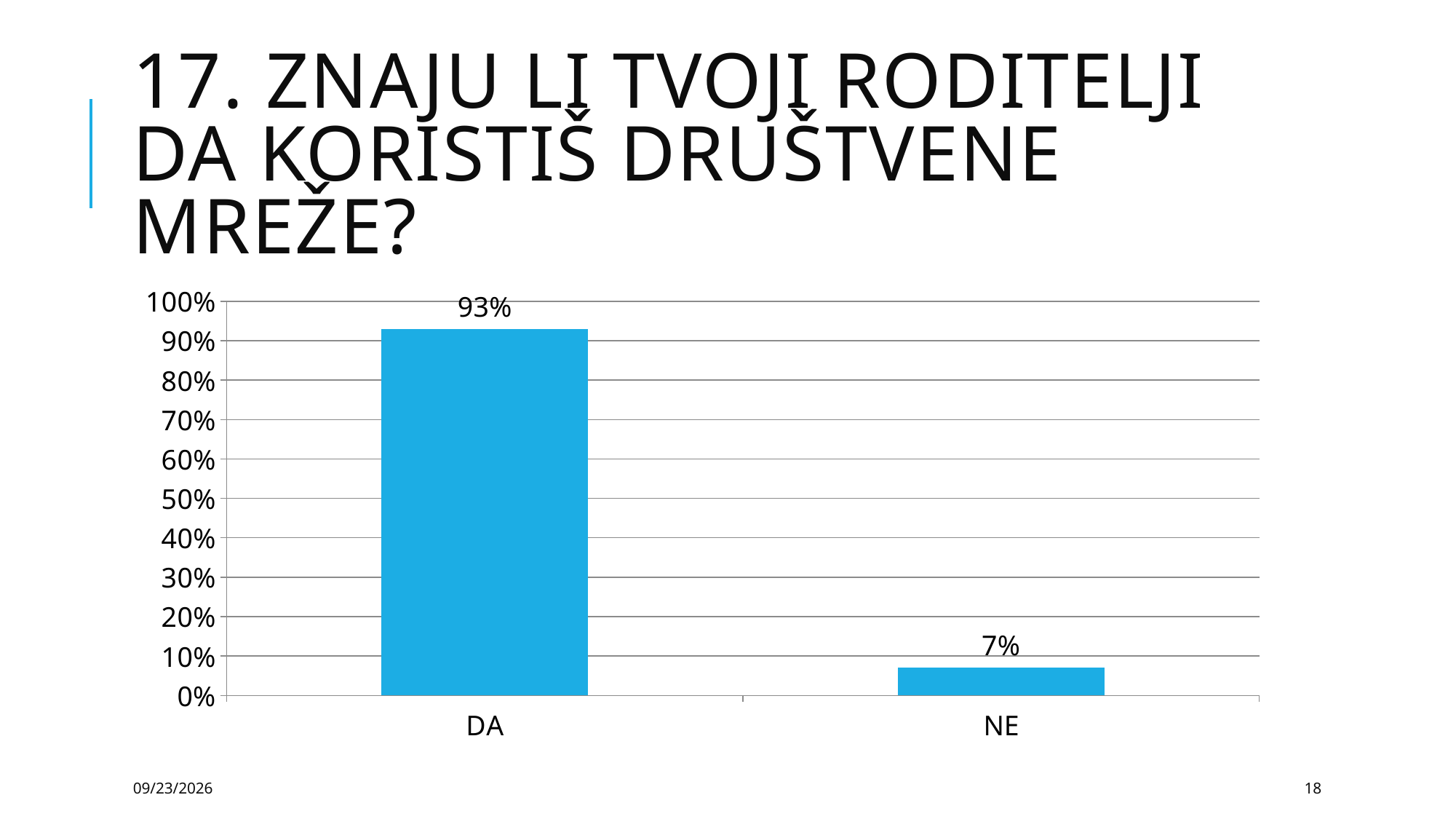
What colour are the bars in the chart? blue What is the value for NE? 7% Is the value for NE greater or less than 10%? less Which is larger, the value for DA or the value for NE? DA What is the highest value shown on the y axis? 100% Is the value for DA greater or less than 50%? greater What is the difference between the values for DA and NE? 86% Which category has the highest value? DA What kind of chart is shown on the slide? bar chart How many categories are shown on the x axis? 2 What is the value for DA? 93% Which category has the lowest value? NE